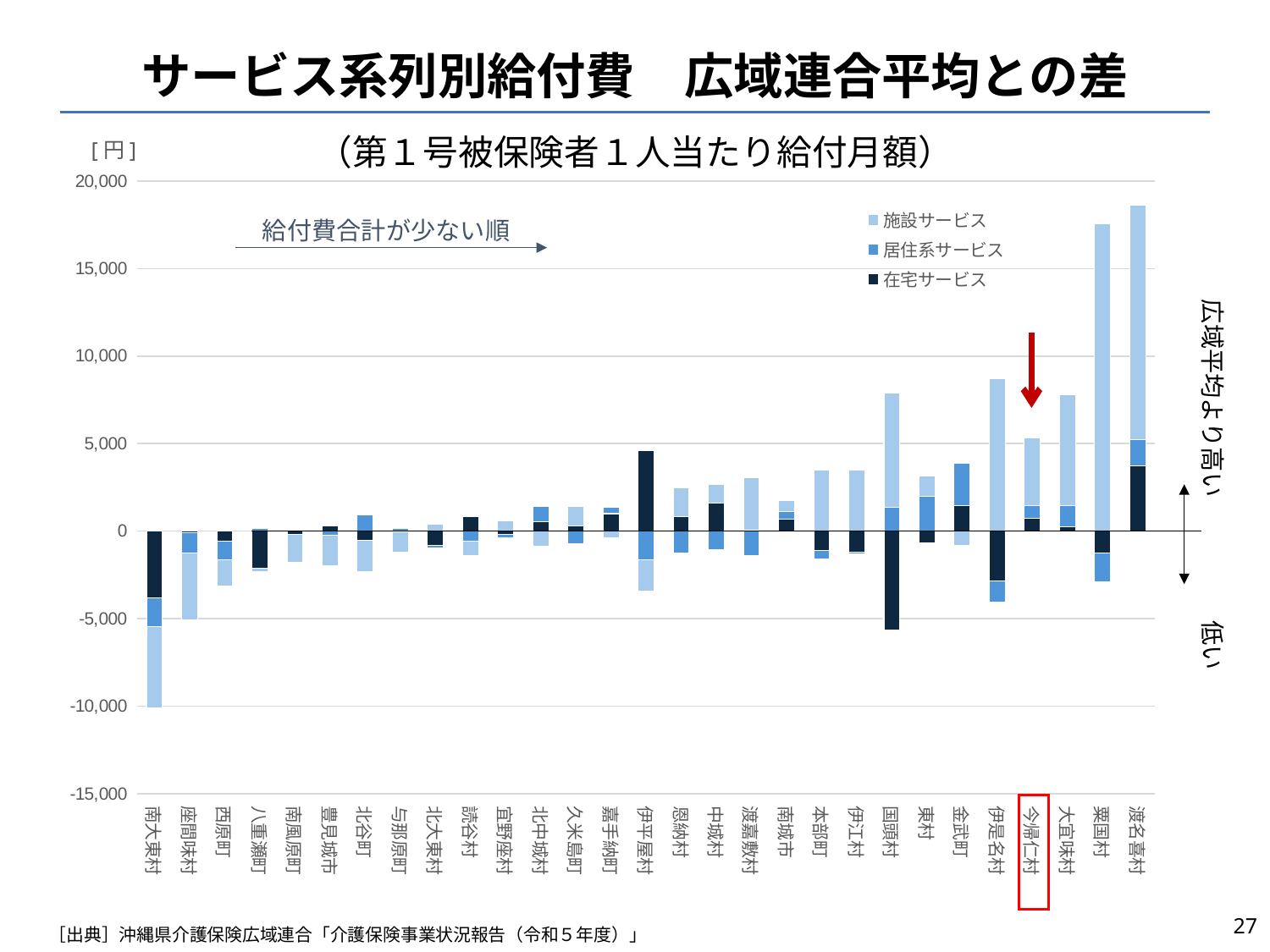
What kind of chart is shown on the slide? stacked bar chart Which has the larger 施設サービス value, 粟国村 or 渡名喜村? 粟国村 How many series does the legend list? 3 Is the 施設サービス value for 国頭村 greater or less than 5,000? greater Is the 在宅サービス value for 国頭村 greater or less than -5,000? less Which municipality has the highest total bar? 渡名喜村 Do the total bar values generally rise or fall from left to right along the x axis? rise Which municipality has the lowest total bar? 南大東村 Is the top of the bar for 渡名喜村 greater or less than 15,000? greater Which municipality's label is highlighted with a red box on the x axis? 今帰仁村 How many municipalities (categories) are plotted on the x axis? 29